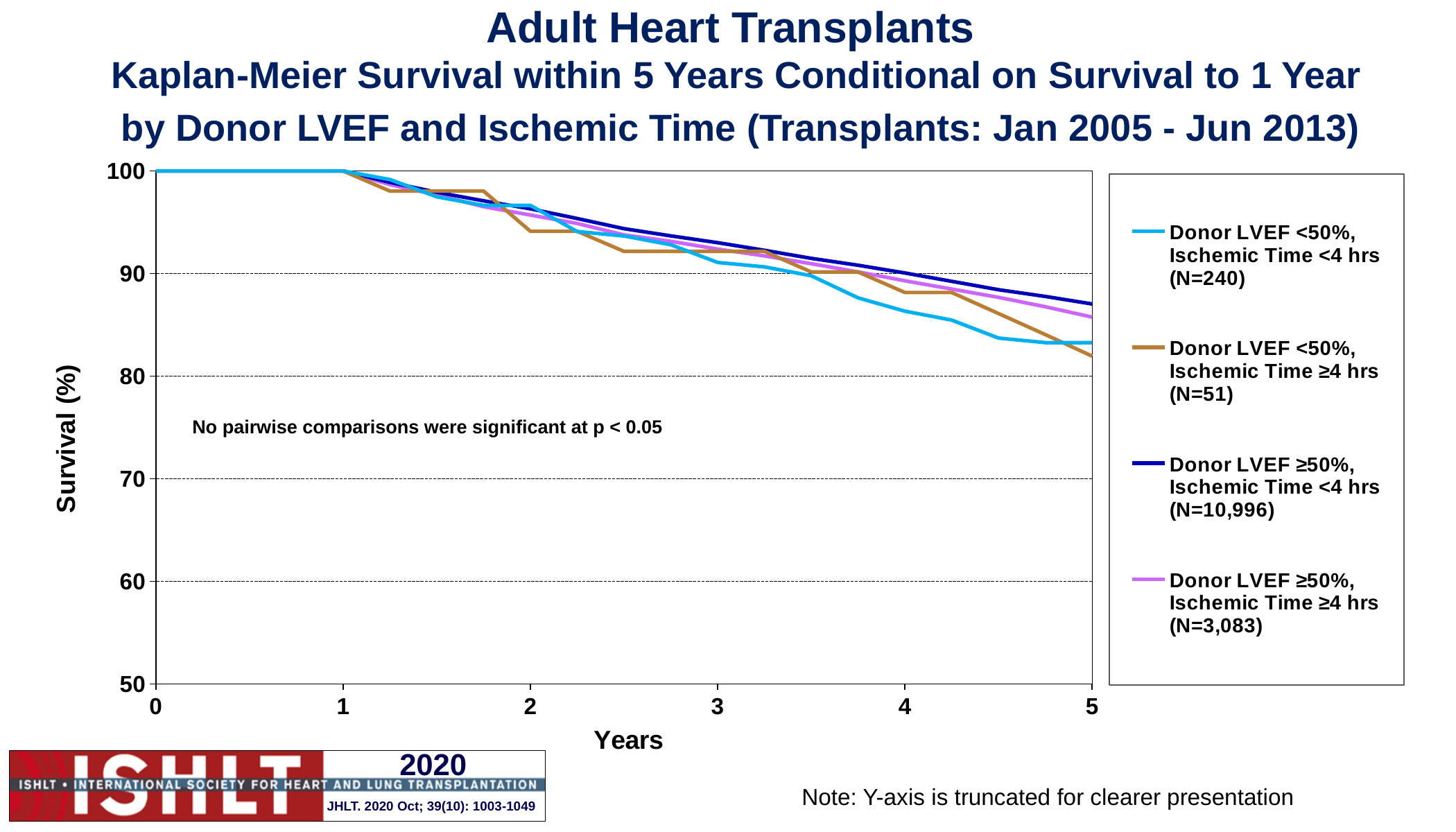
What does the note inside the plot area say about pairwise comparisons? No pairwise comparisons were significant at p < 0.05 Is the value for Donor LVEF <50%, Ischemic Time <4 hrs at year 4 greater or less than 90? less What kind of chart is shown on the slide? line chart Is the value for Donor LVEF ≥50%, Ischemic Time ≥4 hrs at year 3 greater or less than 90? greater What is the N for the Donor LVEF ≥50%, Ischemic Time <4 hrs group in the legend? N=10,996 What is the highest value shown on the y-axis? 100 Is the value for Donor LVEF ≥50%, Ischemic Time <4 hrs at year 5 greater or less than 80? greater Do the survival curves rise or fall as years increase? fall What is the survival value for all series at year 0? 100 At year 5, which is higher: Donor LVEF ≥50%, Ischemic Time <4 hrs or Donor LVEF <50%, Ischemic Time ≥4 hrs? Donor LVEF ≥50%, Ischemic Time <4 hrs How many series does the legend list? 4